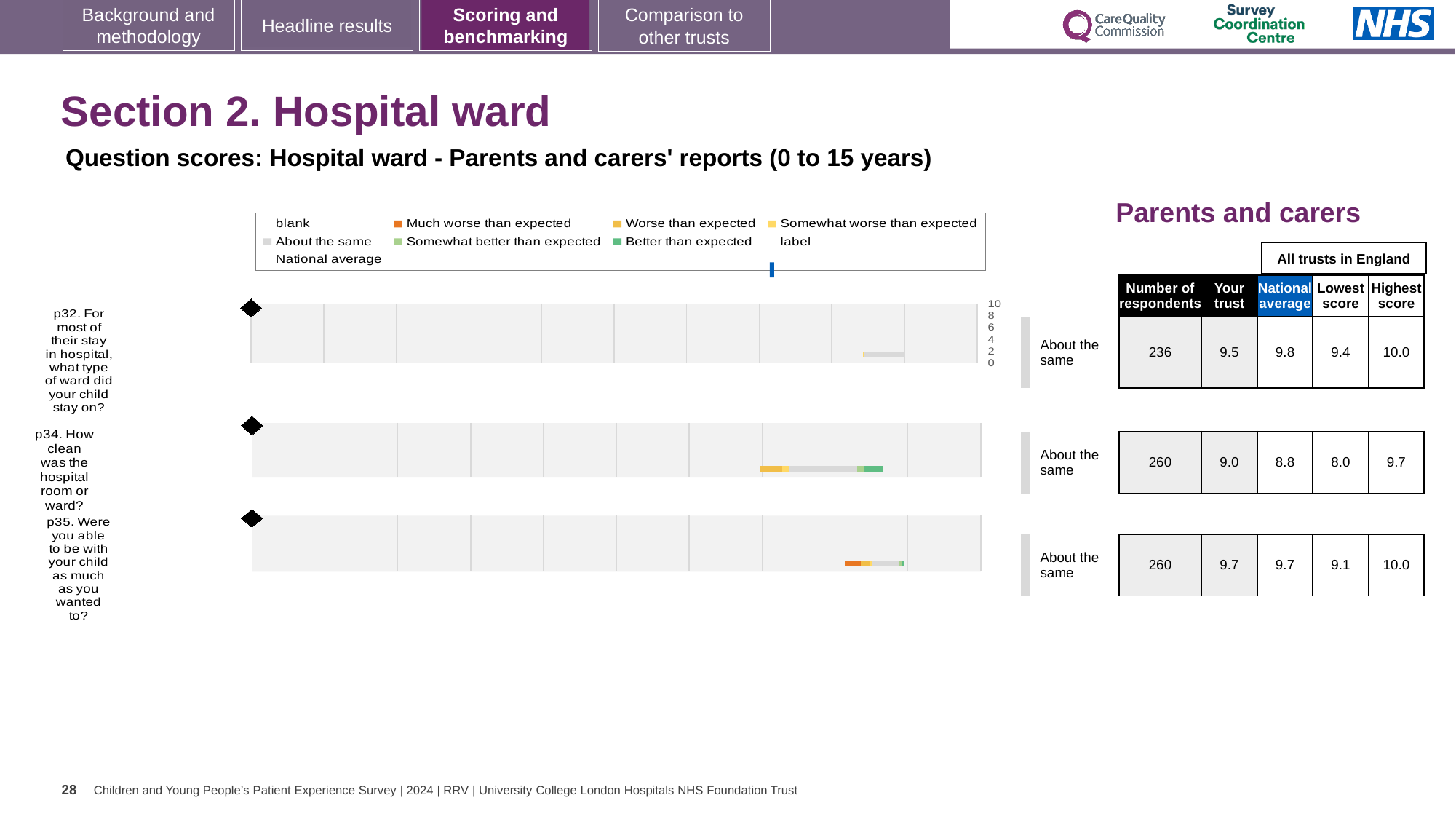
What is the 'Your trust' score for p34 (How clean was the hospital room or ward?)? 9.0 How many questions (p32, p34, p35) are plotted on the slide? 3 What benchmark category is shown for p35 (Were you able to be with your child as much as you wanted to?)? About the same What kind of chart is used to show the question scores on this slide? bar chart For p34, which is larger: the trust's score or the national average? Your trust What is the lowest score among all trusts in England for p35? 9.1 How many respondents are listed for p32 (what type of ward did your child stay on)? 236 Which question has the highest 'Your trust' score? p35 Which question has the lowest 'Your trust' score? p34 For p32, what is the difference between the national average (9.8) and the trust's score (9.5)? 0.3 In the chart legend, what colour represents 'Better than expected'? green What is the highest score among all trusts in England for p34? 9.7